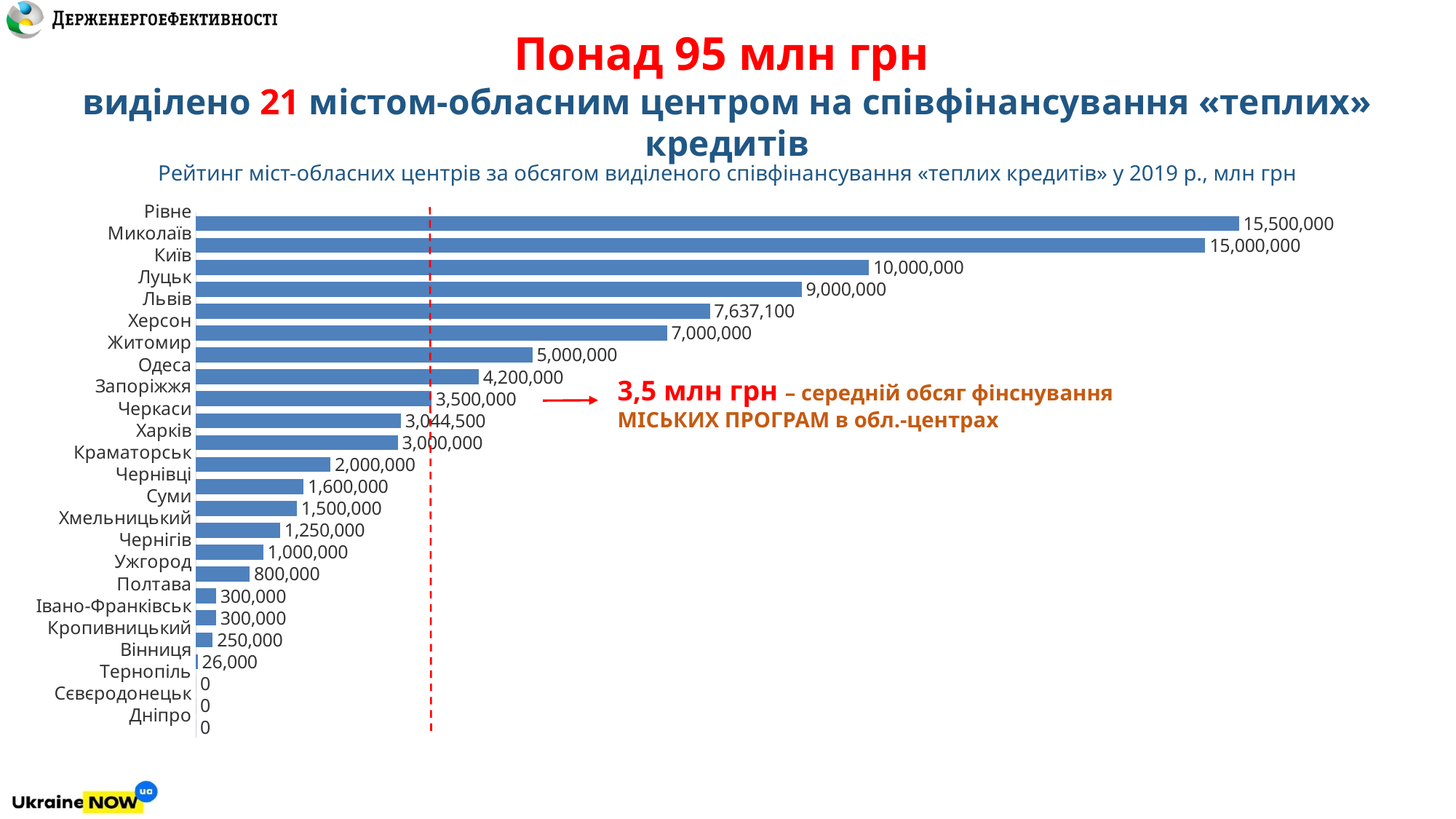
What kind of chart is shown on the slide? bar chart How many cities are listed in the chart? 24 Which city has the highest value in the chart? Рівне What is the value for Рівне? 15,500,000 What is the value for Вінниця? 26,000 What is the value for Миколаїв? 15,000,000 What average value does the red dashed line in the chart mark? 3,5 млн грн Which is larger, the value for Київ or the value for Луцьк? Київ What is the value for Львів? 7,637,100 What is the difference between the values for Рівне and Миколаїв? 500,000 What is the value for Черкаси? 3,044,500 How many cities have a value of 0 in the chart? 3